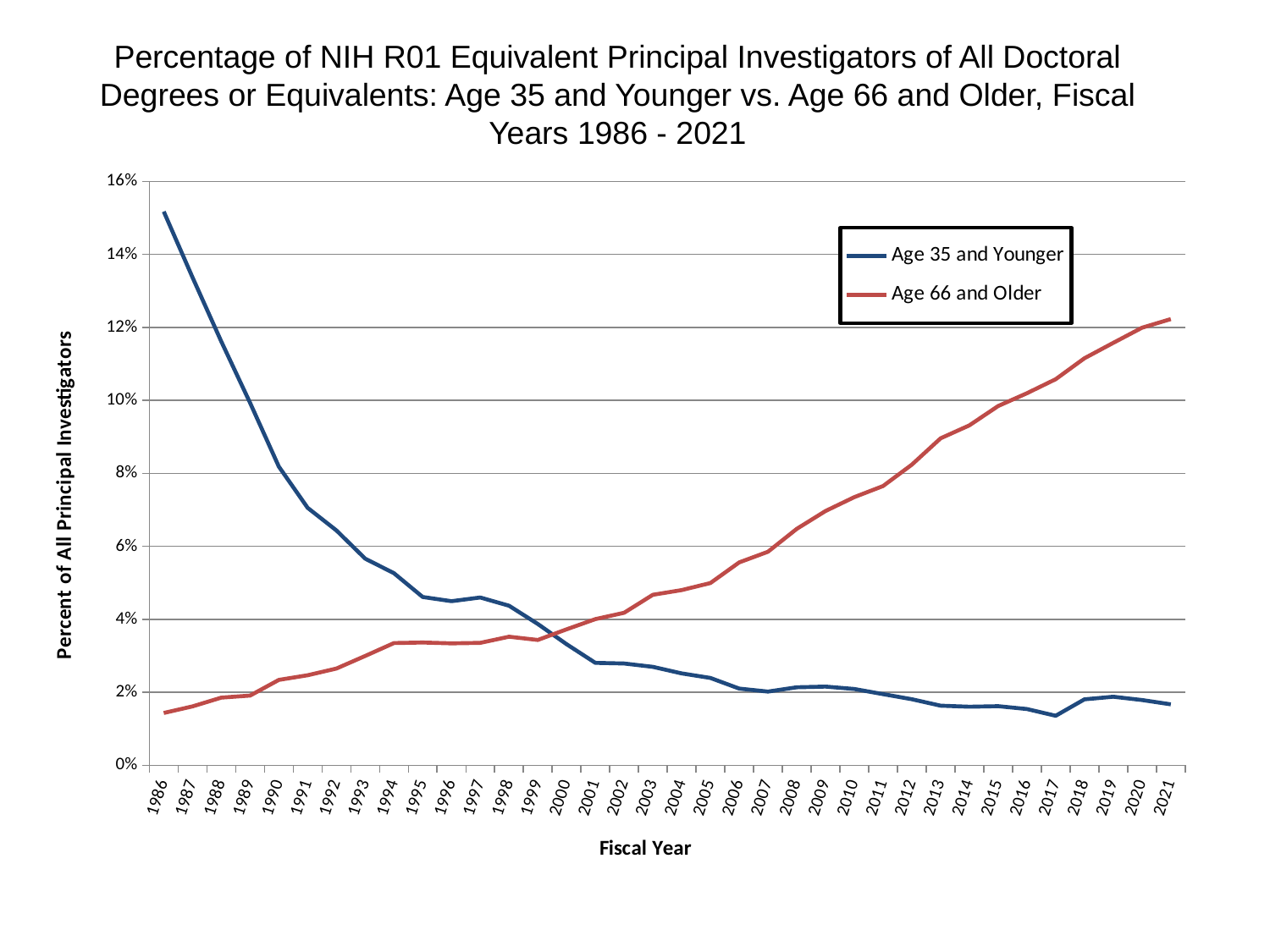
How many fiscal years are plotted along the x axis? 36 In 2010, which series has the higher value, Age 35 and Younger or Age 66 and Older? Age 66 and Older How many series does the legend list? 2 What kind of chart is shown on the slide? Line chart Does the Age 35 and Younger line rise or fall from 1986 to 2021? Fall Is the value for Age 35 and Younger in 2021 greater or less than 2%? less Is the value for Age 66 and Older in 1986 greater or less than 2%? less What is the label of the y axis? Percent of All Principal Investigators Is the value for Age 35 and Younger in 1986 greater or less than 14%? greater Does the Age 66 and Older line rise or fall from 1986 to 2021? Rise In which fiscal year is the Age 35 and Younger series at its highest? 1986